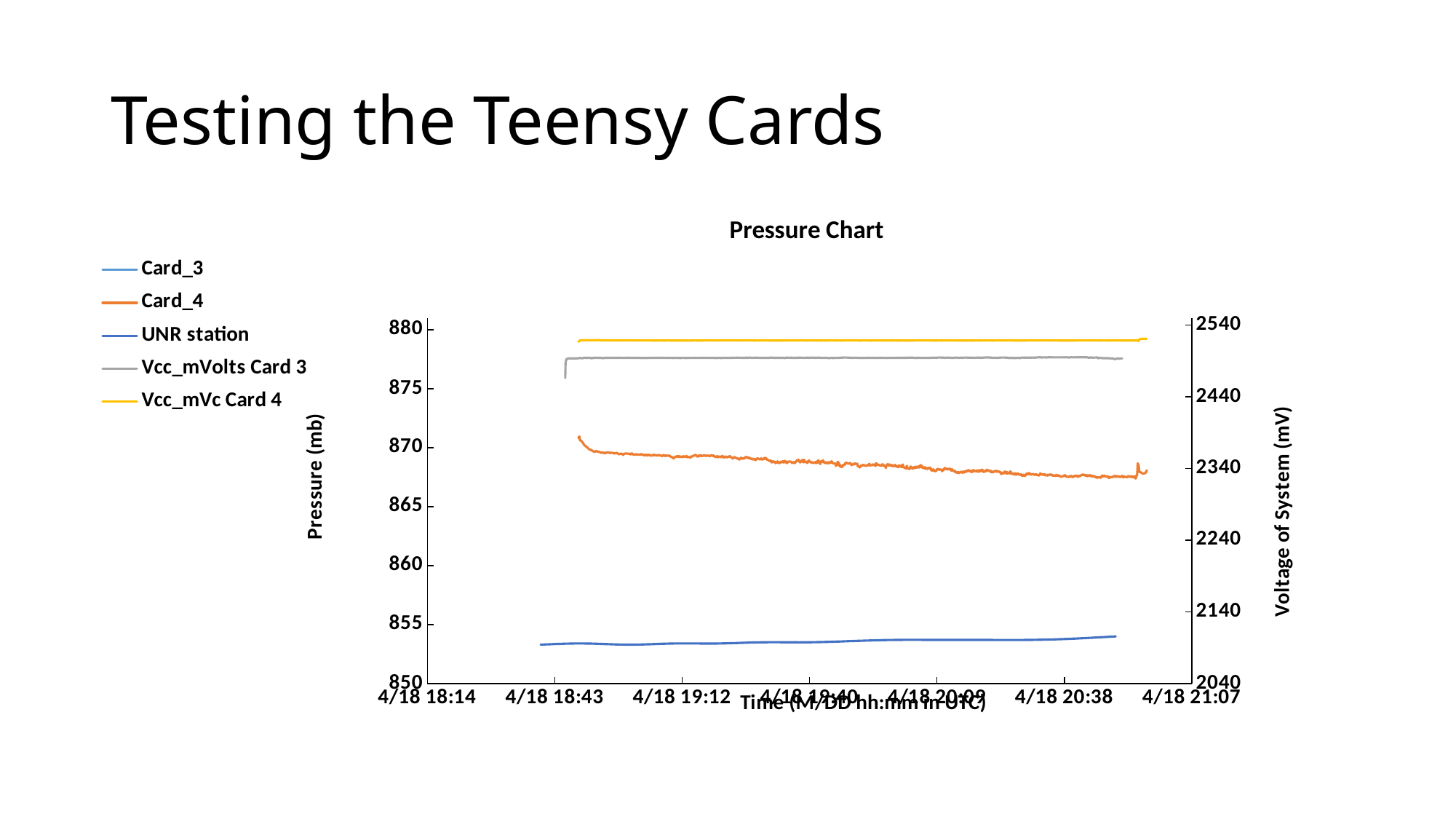
What type of chart is shown on the slide? line chart What is the title of the chart? Pressure Chart Is the Card_4 pressure value greater or less than 875 mb? less Is the Vcc_mVolts Card 3 voltage greater or less than 2440 mV? greater Is the Vcc_mVc Card 4 voltage greater or less than 2440 mV? greater What is the label of the right-hand vertical axis? Voltage of System (mV) How many series does the chart legend list? 5 Does the Card_4 pressure line rise or fall over time along the x axis? fall Which series is plotted highest on the chart? Vcc_mVc Card 4 Which series has the higher voltage, Vcc_mVc Card 4 or Vcc_mVolts Card 3? Vcc_mVc Card 4